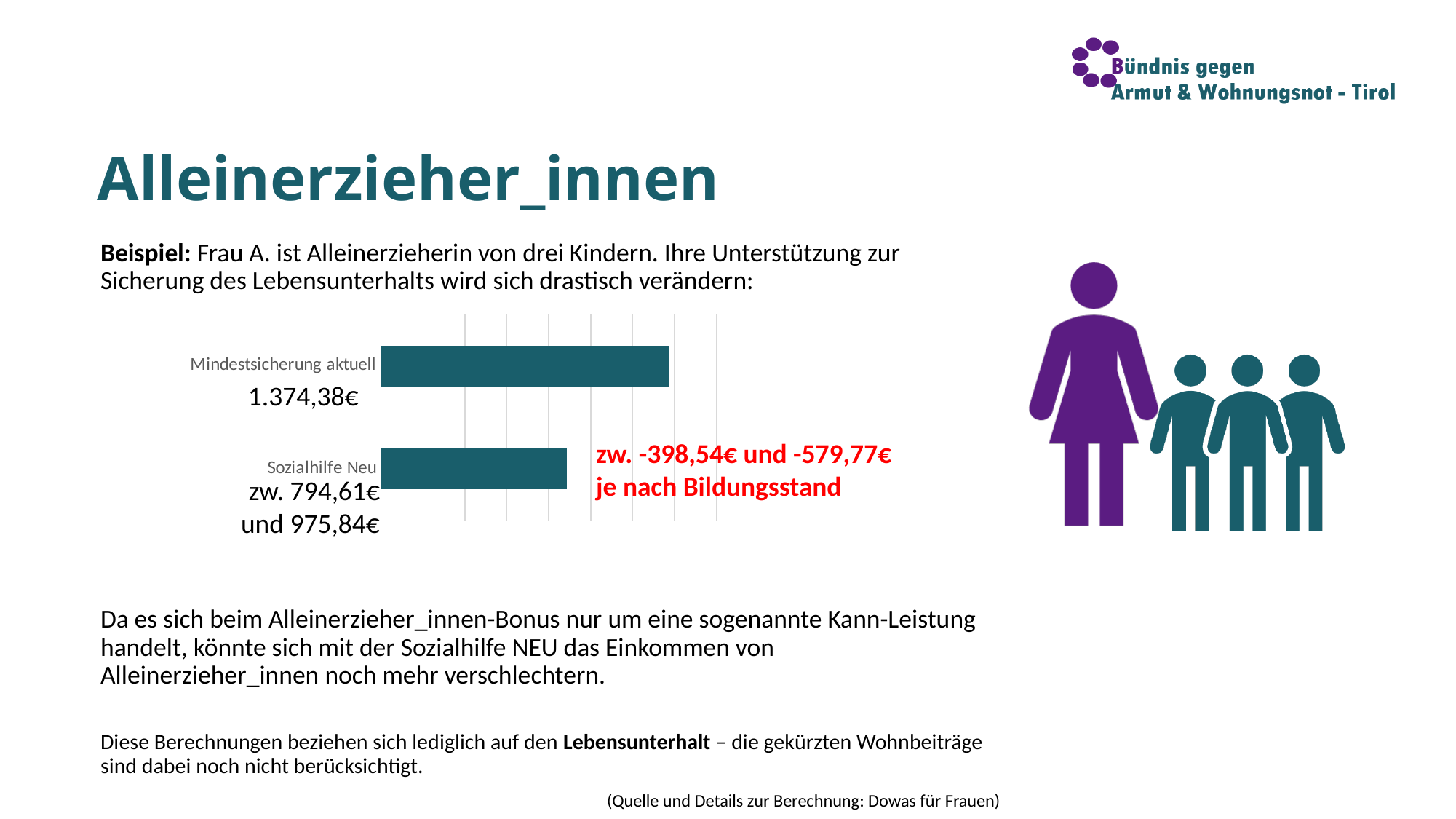
What value is shown for Mindestsicherung aktuell? 1.374,38€ According to the red annotation, what does the size of the reduction depend on? Bildungsstand Is the bar for Mindestsicherung aktuell longer or shorter than the bar for Sozialhilfe Neu? longer Are the bars in the chart horizontal or vertical? horizontal Which category has the shorter bar? Sozialhilfe Neu What value range is shown for Sozialhilfe Neu? zw. 794,61€ und 975,84€ According to the red annotation, what is the difference between Mindestsicherung aktuell and Sozialhilfe Neu? zw. -398,54€ und -579,77€ Which category has the longer bar? Mindestsicherung aktuell How many bars does the chart show? 2 What kind of chart is shown on the slide? bar chart